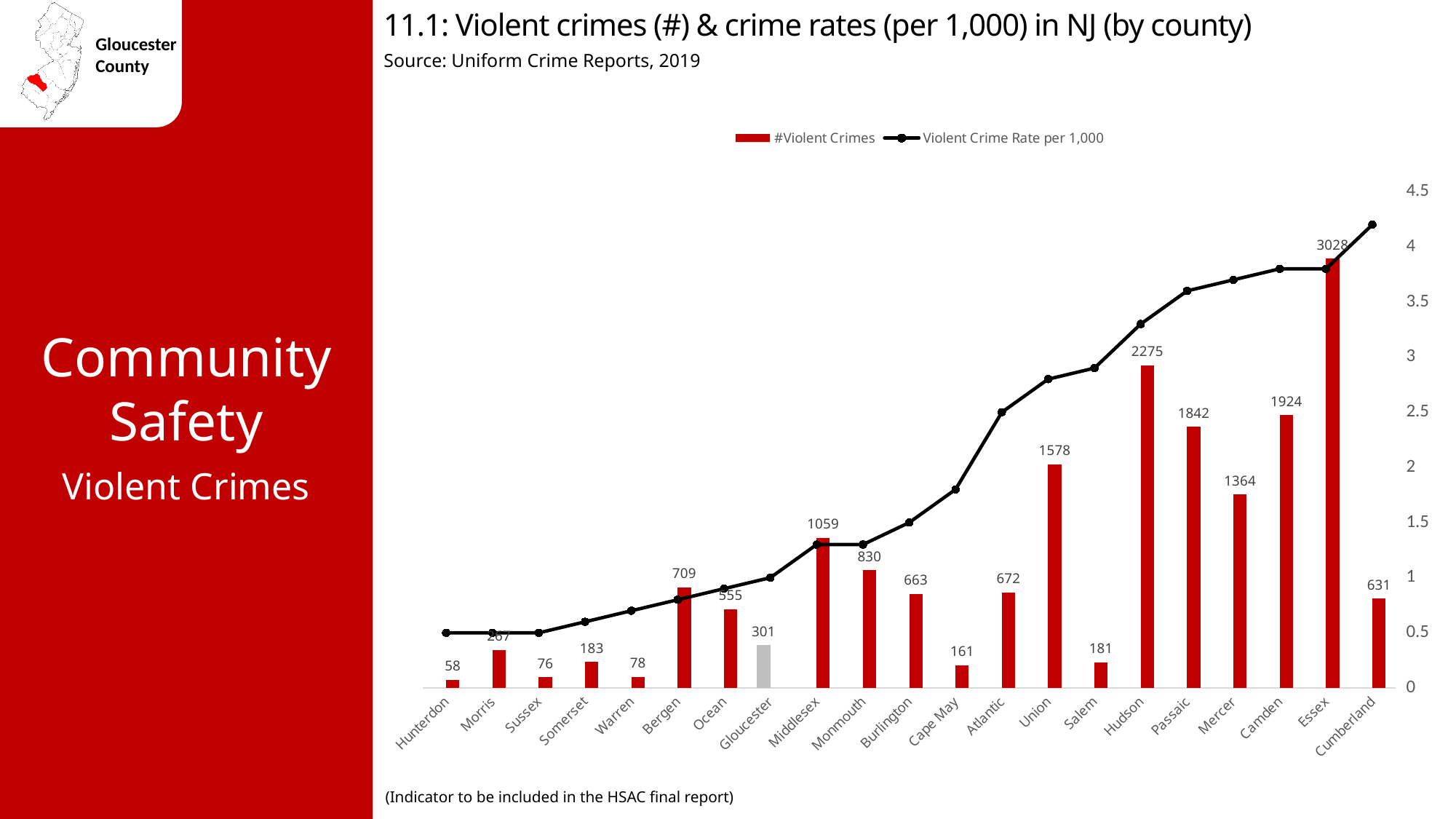
Which county has the lowest number of violent crimes? Hunterdon Does the violent crime rate per 1,000 line generally rise or fall from Hunterdon to Cumberland? rise Which county has more violent crimes, Union or Mercer? Union Which county has the highest number of violent crimes? Essex What is the difference in the number of violent crimes between Camden and Passaic? 82 Is the violent crime rate per 1,000 for Hunterdon greater or less than 1? less What is the number of violent crimes for Gloucester? 301 What is the number of violent crimes for Hudson? 2275 What is the number of violent crimes for Essex? 3028 Is the violent crime rate per 1,000 for Cumberland greater or less than 4? greater How many counties are shown on the x axis? 21 How many series does the legend list? 2